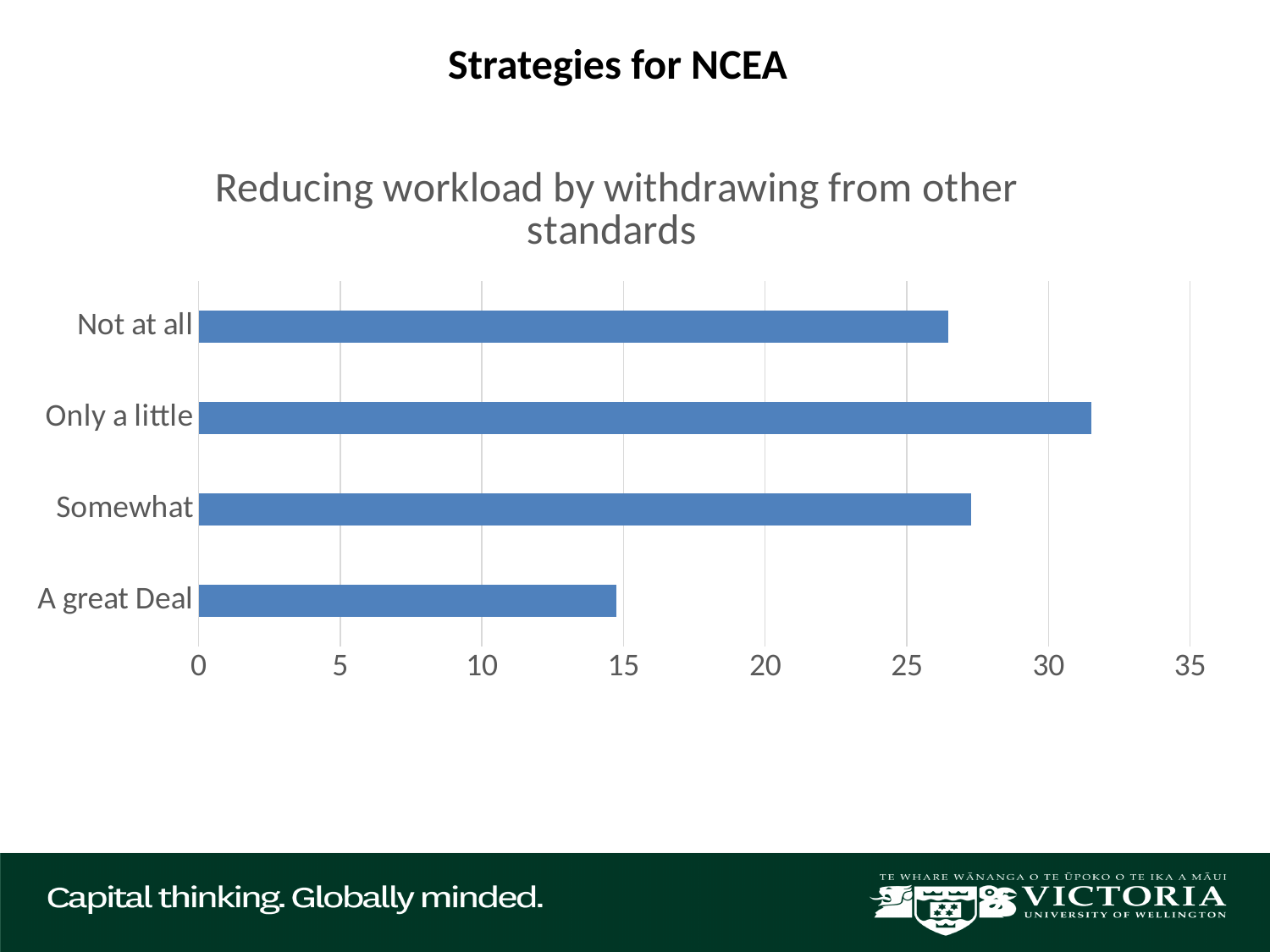
Is the value for "Not at all" greater or less than 25? greater What is the title of the chart? Reducing workload by withdrawing from other standards Which category has the lowest value? A great Deal Which category has the highest value? Only a little What kind of chart is shown on the slide? bar chart What is the maximum value shown on the horizontal axis? 35 Is the value for "Only a little" greater or less than 30? greater Which is larger, the value for "Only a little" or the value for "A great Deal"? Only a little Which is larger, the value for "Somewhat" or the value for "A great Deal"? Somewhat Is the value for "Somewhat" greater or less than 30? less How many categories are plotted in the chart? 4